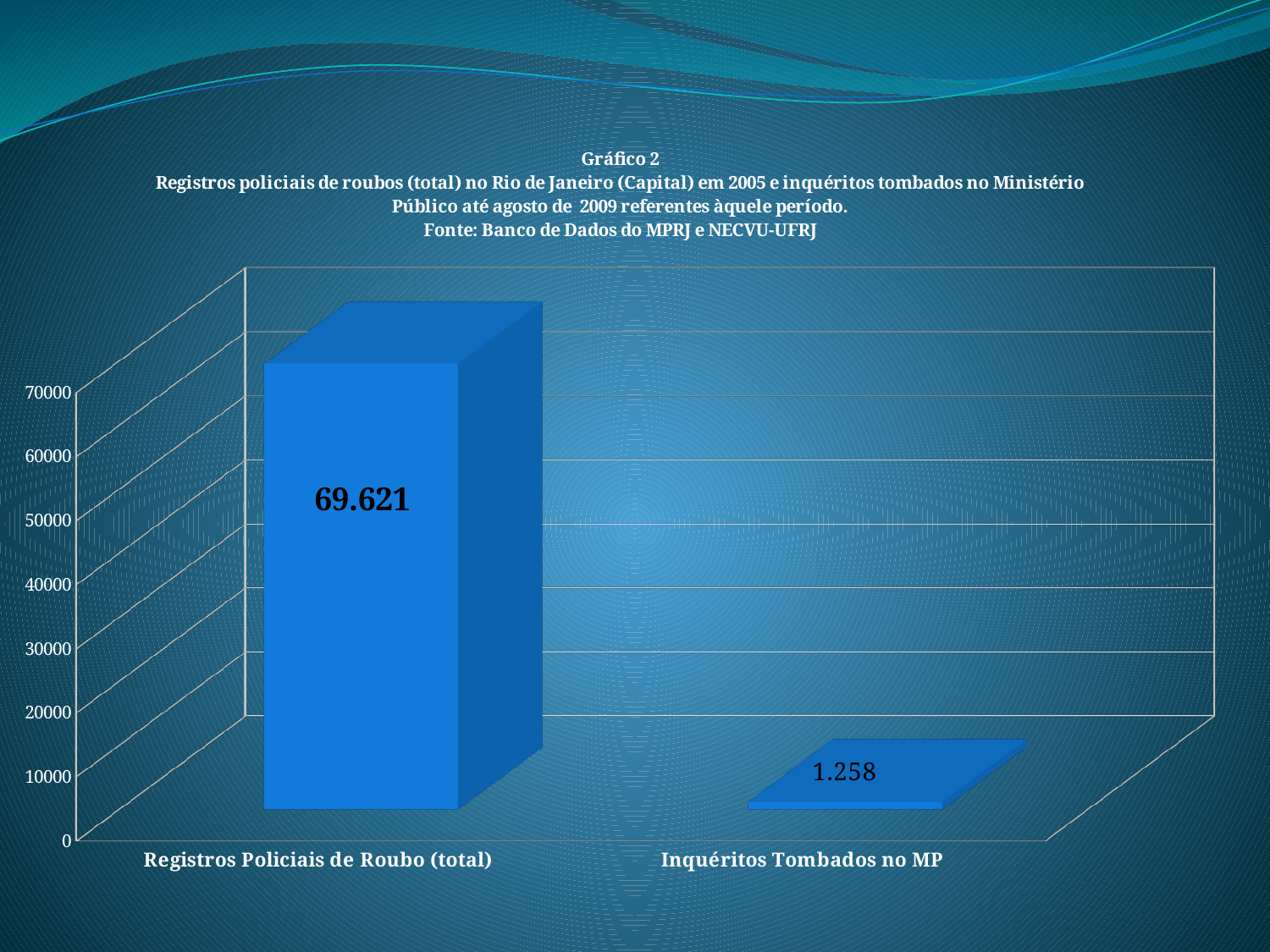
Is the value for Registros Policiais de Roubo (total) greater or less than 60000? greater Which category has the highest value? Registros Policiais de Roubo (total) Which is larger: the value for Registros Policiais de Roubo (total) or the value for Inquéritos Tombados no MP? Registros Policiais de Roubo (total) What is the highest value shown on the vertical axis? 70000 What kind of chart is shown on the slide? bar chart What is the value for Inquéritos Tombados no MP? 1.258 What is the source cited in the chart title? Banco de Dados do MPRJ e NECVU-UFRJ What is the value for Registros Policiais de Roubo (total)? 69.621 Is the value for Inquéritos Tombados no MP greater or less than 10000? less How many categories are shown on the chart? 2 What is the difference between the value for Registros Policiais de Roubo (total) and the value for Inquéritos Tombados no MP? 68.363 Which category has the lowest value? Inquéritos Tombados no MP